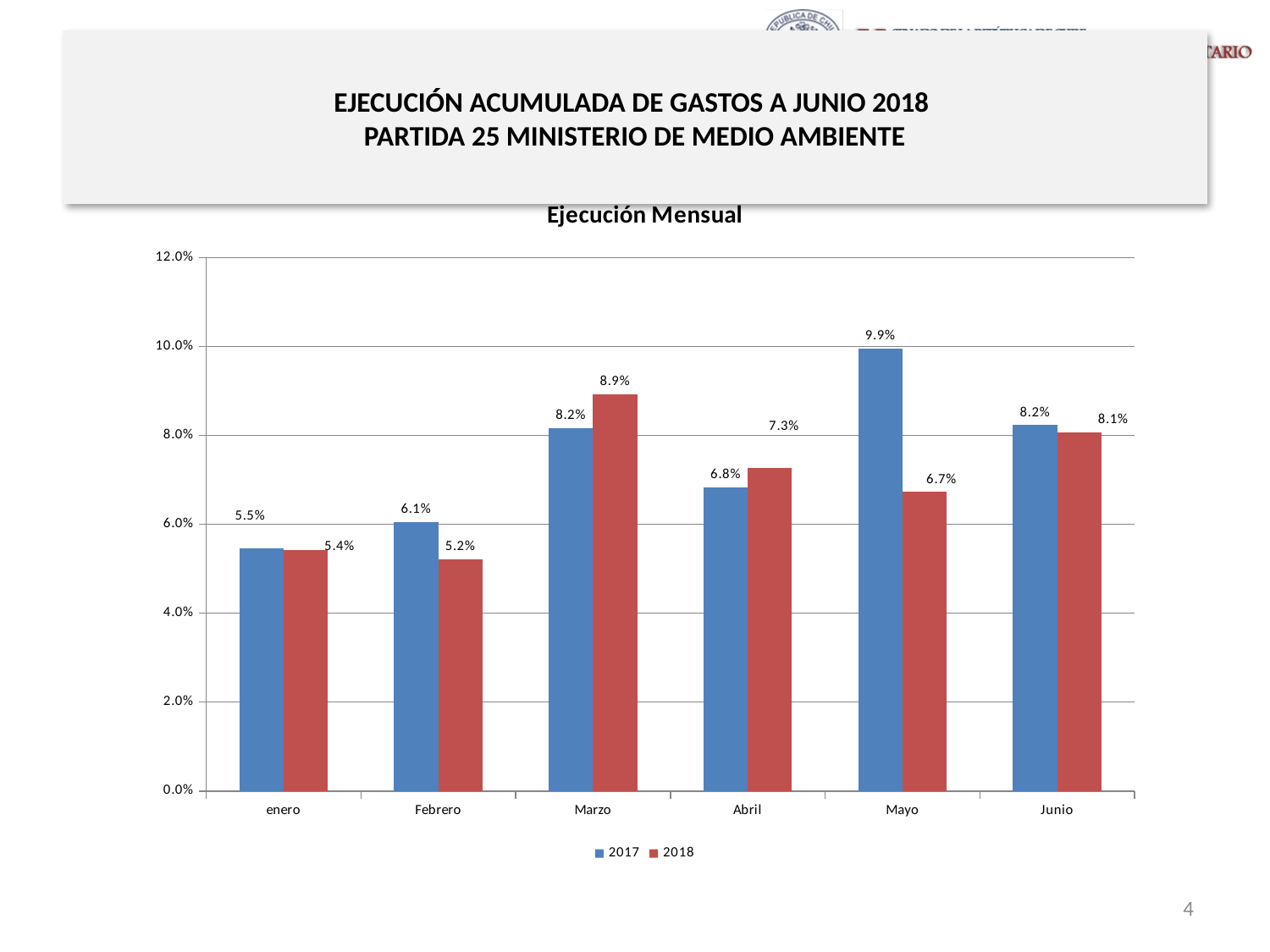
What is the title of the chart? Ejecución Mensual Which month has the lowest value for the 2018 series? Febrero Which is larger in Abril, the 2017 value or the 2018 value? 2018 What kind of chart is shown? bar chart What is the difference between the 2017 and 2018 values in Mayo? 3.2% Which month has the highest value for the 2017 series? Mayo How many series does the legend list? 2 How many months are shown on the x axis? 6 What is the value for 2018 in Marzo? 8.9% What is the value for 2017 in Mayo? 9.9% Is the 2017 value for Marzo greater or less than 8.0%? greater What is the value for 2018 in enero? 5.4%